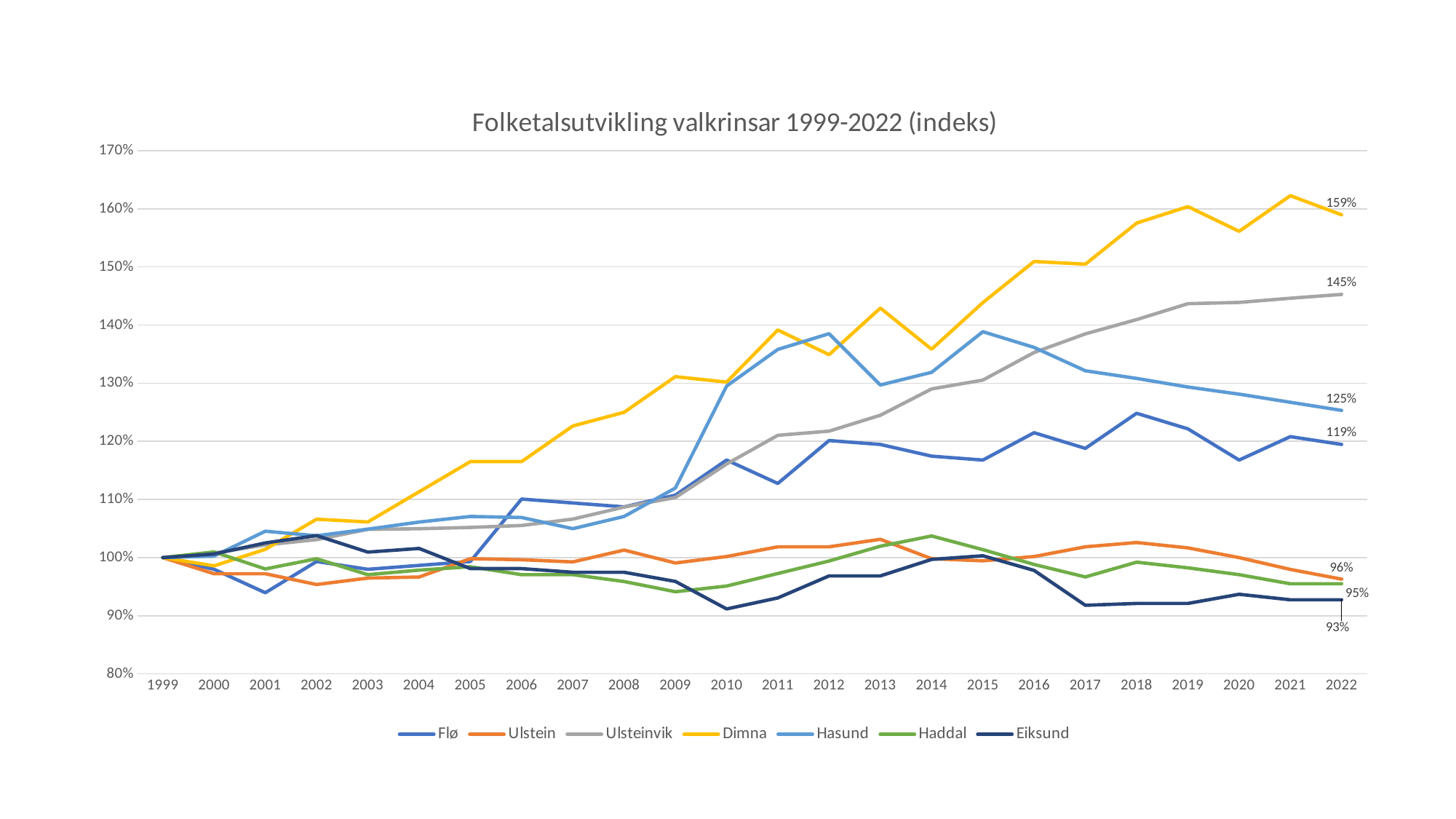
Which series has the highest value in 2022? Dimna Is the value for Eiksund in 2010 greater or less than 100%? less What is the value for Ulsteinvik in 2022? 145% Which is larger in 2022, Hasund or Flø? Hasund What kind of chart is shown on the slide? line chart Does the Dimna series generally rise or fall from 1999 to 2022? rise Which series has the lowest value in 2022? Eiksund What is the value for Dimna in 2022? 159% How many series does the legend list? 7 What is the value for Hasund in 2022? 125% What is the value for Eiksund in 2022? 93% What is the difference between the 2022 values for Dimna and Ulsteinvik? 14 percentage points